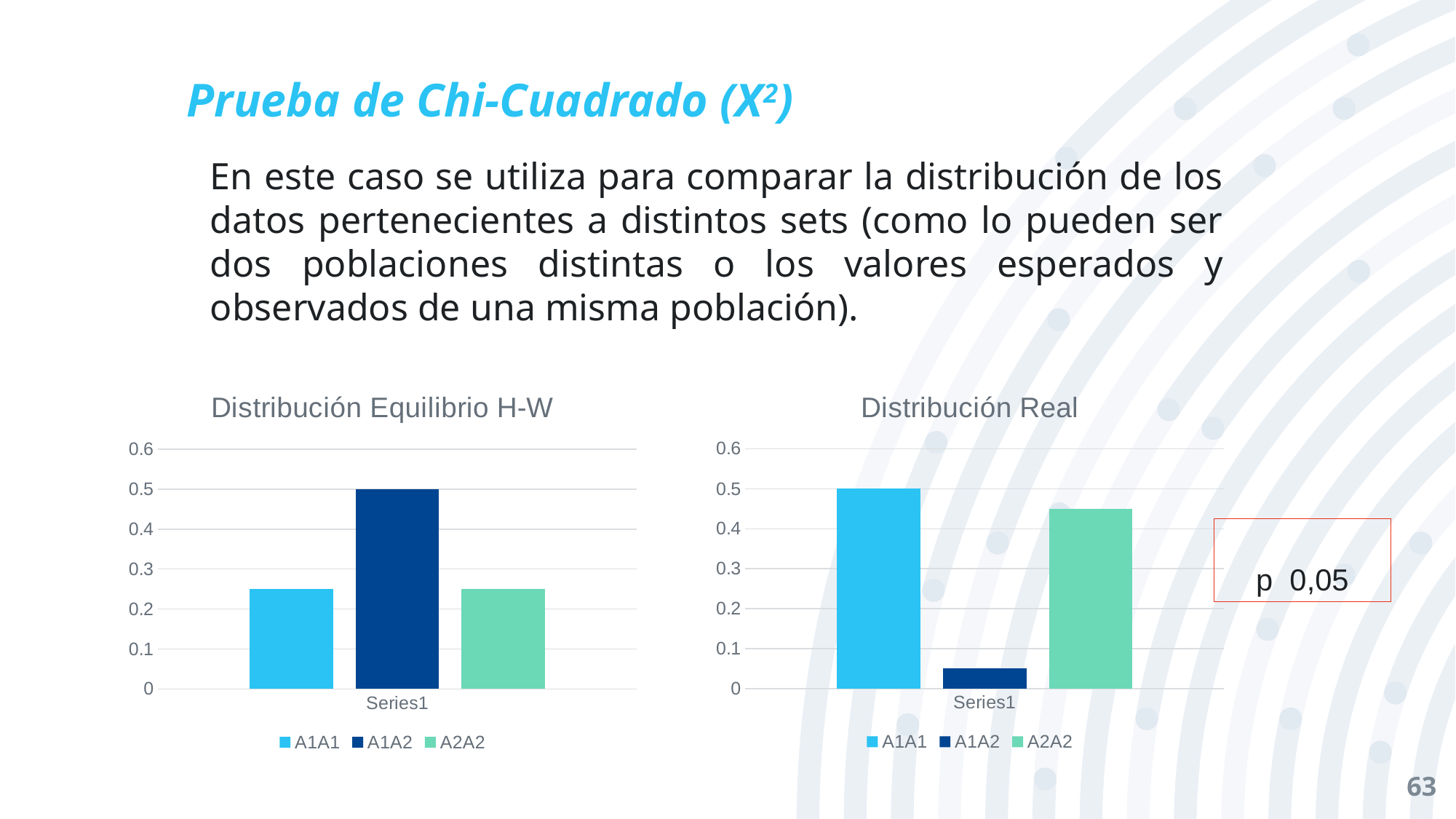
How many series does the legend of the chart titled "Distribución Equilibrio H-W" list? 3 In the chart titled "Distribución Real", which series has the lowest bar? A1A2 In the chart titled "Distribución Real", is the value for A2A2 greater or less than 0.4? greater In the chart titled "Distribución Real", which series has the highest bar? A1A1 What is the title of the chart on the left side of the slide? Distribución Equilibrio H-W In the chart titled "Distribución Equilibrio H-W", what is the value for A1A2? 0.5 What kind of chart is the chart titled "Distribución Real"? bar chart In the chart titled "Distribución Real", what is the value for A1A1? 0.5 In the chart titled "Distribución Real", is the value for A1A2 greater or less than 0.1? less In the chart titled "Distribución Equilibrio H-W", which series has the highest bar? A1A2 In the chart titled "Distribución Equilibrio H-W", is the value for A1A1 greater or less than 0.3? less In the chart titled "Distribución Real", which is larger, the value for A1A1 or the value for A1A2? A1A1